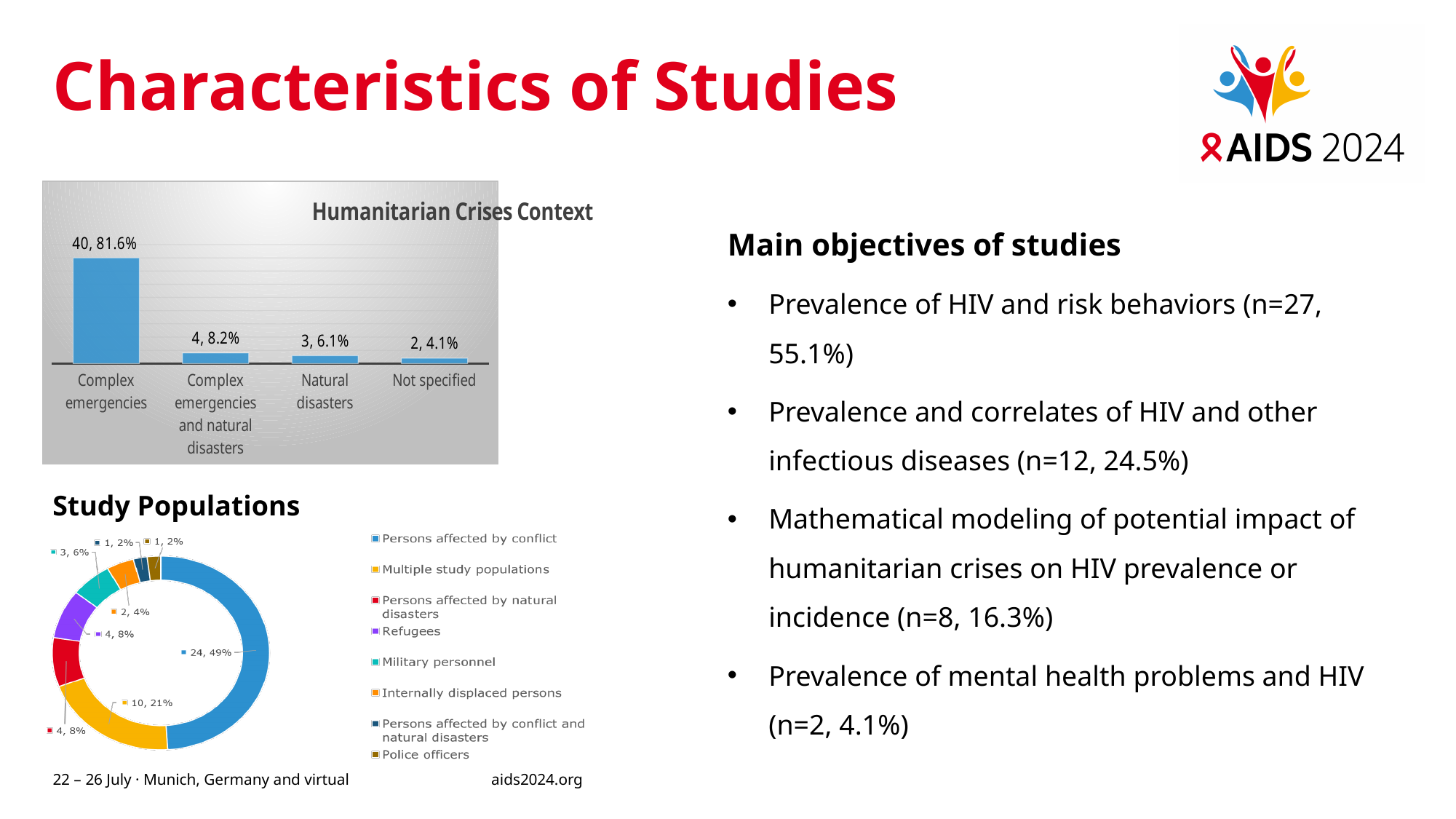
In the Humanitarian Crises Context chart, what is the value for Complex emergencies? 40, 81.6% What kind of chart is the Study Populations chart? Doughnut chart In the Humanitarian Crises Context chart, which category has the lowest value? Not specified In the Humanitarian Crises Context chart, what is the difference in number of studies between Complex emergencies and Complex emergencies and natural disasters? 36 In the Study Populations chart, what share of the chart is Multiple study populations? 21% In the Study Populations chart, which is larger: Military personnel or Internally displaced persons? Military personnel In the Study Populations chart, what is the value for Persons affected by conflict? 24, 49% What kind of chart is the Humanitarian Crises Context chart? Bar chart How many entries does the legend of the Study Populations chart list? 8 In the Humanitarian Crises Context chart, what is the value for Natural disasters? 3, 6.1% In the Study Populations chart, which category has the largest share? Persons affected by conflict How many categories are shown in the Humanitarian Crises Context chart? 4